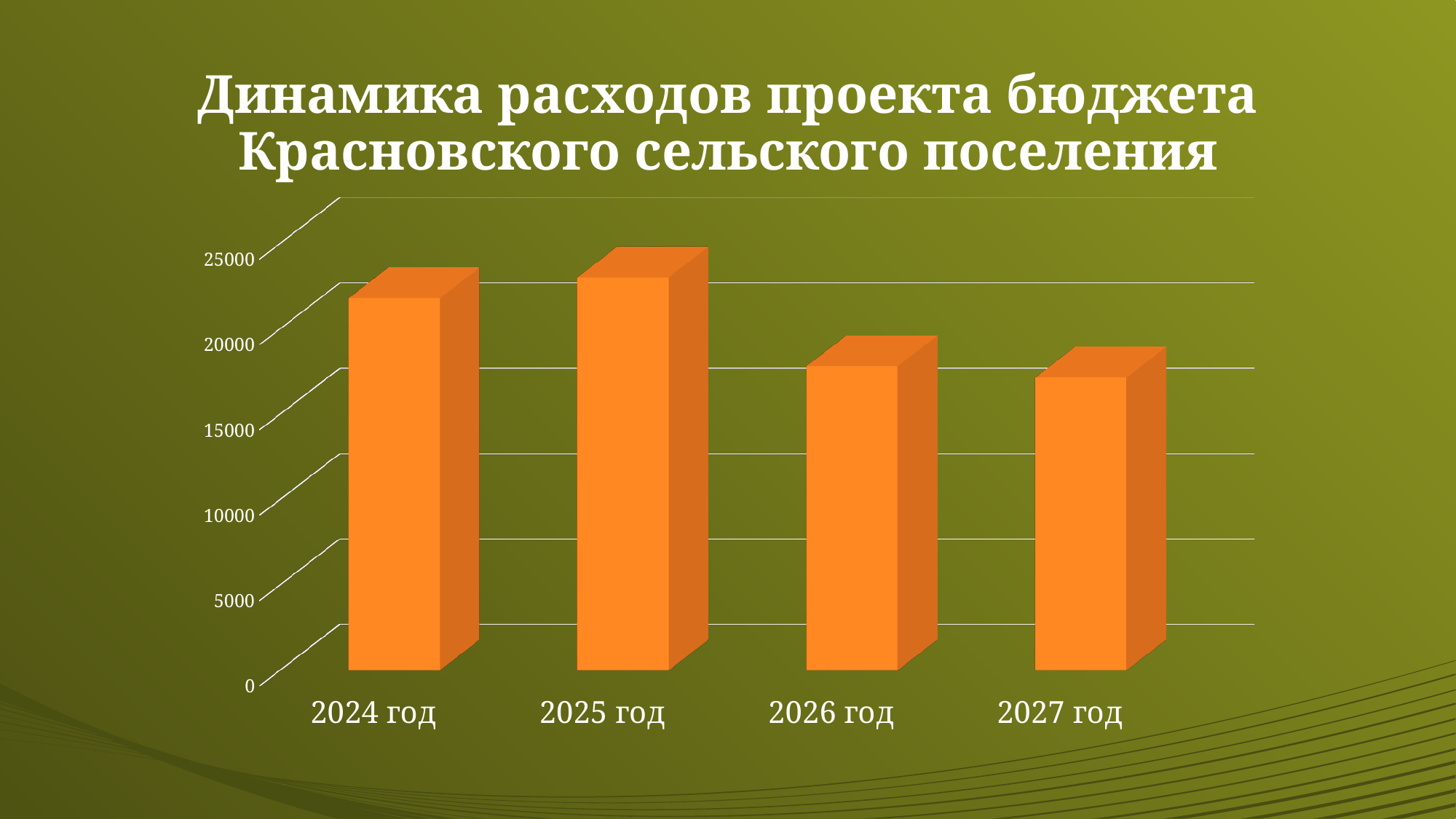
Is the value for 2027 год greater or less than 15000? greater Which year has the highest bar in the chart? 2025 год Which is larger, the value for 2024 год or the value for 2025 год? 2025 год Is the value for 2024 год greater or less than 20000? greater What kind of chart is shown on the slide? bar chart What is the title of the chart on the slide? Динамика расходов проекта бюджета Красновского сельского поселения Which year has the lowest bar in the chart? 2027 год Is the value for 2025 год greater or less than 25000? less How many years (categories) are shown on the x axis of the chart? 4 Which is larger, the value for 2025 год or the value for 2026 год? 2025 год Do the values rise or fall from 2025 год to 2027 год? fall